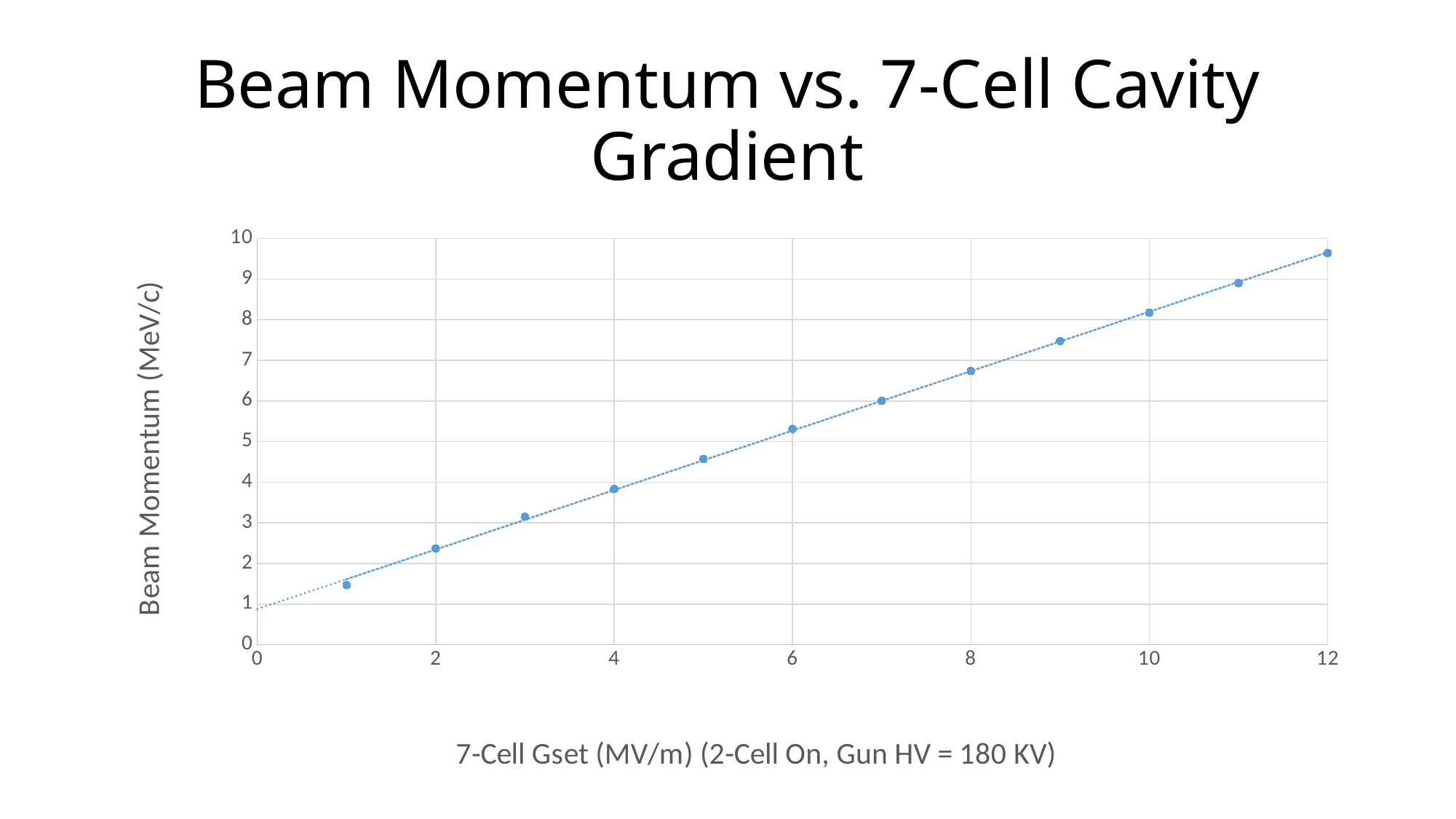
What kind of chart is shown on the slide? scatter chart Is the beam momentum at a 7-Cell Gset of 2 MV/m greater or less than 2 MeV/c? greater Which has the larger beam momentum: a 7-Cell Gset of 3 MV/m or 9 MV/m? 9 MV/m Is the beam momentum at a 7-Cell Gset of 12 MV/m greater or less than 10 MeV/c? less At which 7-Cell Gset value is the beam momentum lowest? 1 What is the title of the chart? Beam Momentum vs. 7-Cell Cavity Gradient Is the beam momentum at a 7-Cell Gset of 4 MV/m greater or less than 4 MeV/c? less What is the label of the y axis? Beam Momentum (MeV/c) Do the beam momentum values rise or fall as the 7-Cell Gset increases along the x axis? rise At which 7-Cell Gset value is the beam momentum highest? 12 How many data points are plotted on the chart? 12